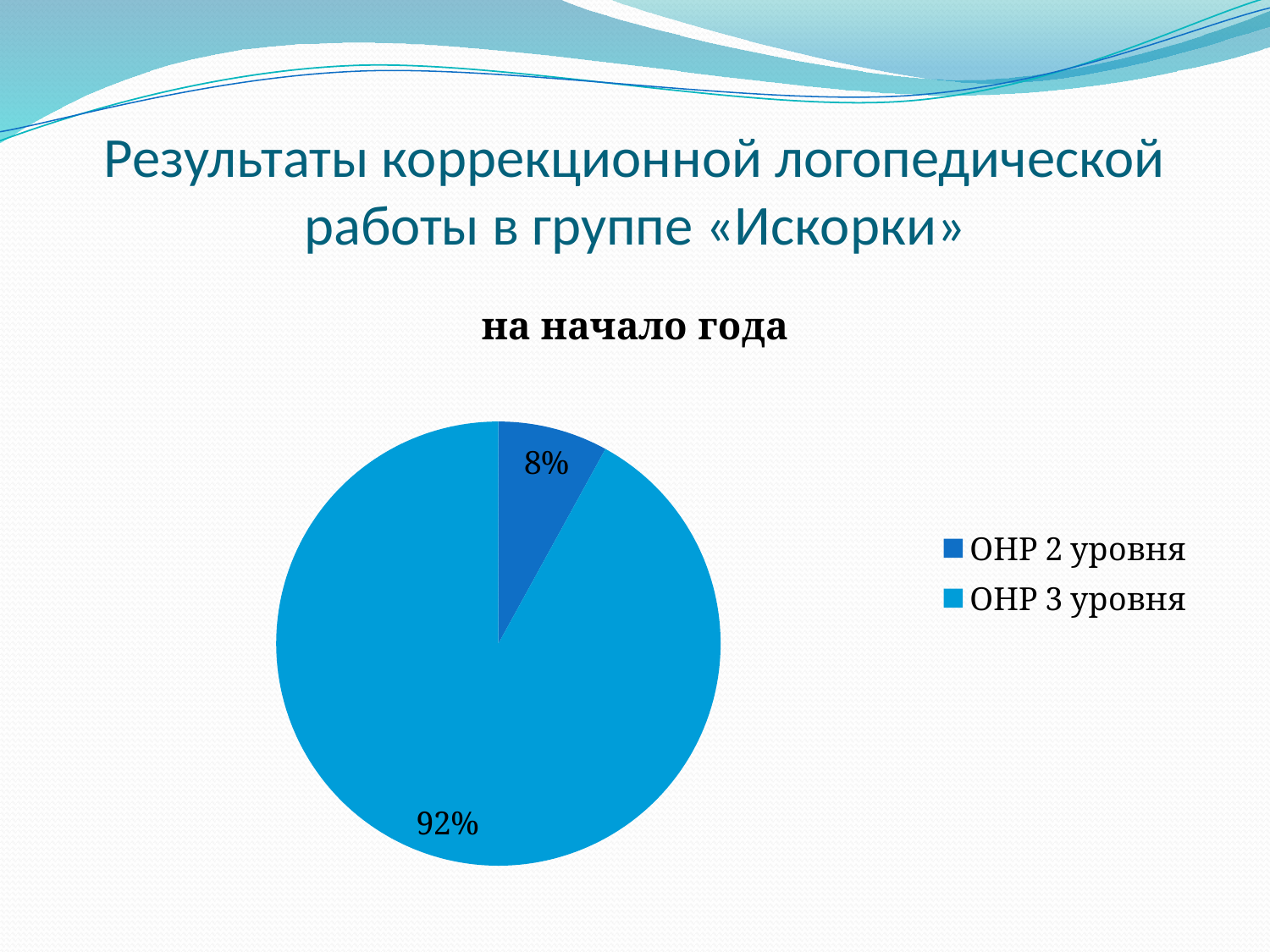
Which legend entry is shown in the darker blue colour? ОНР 2 уровня What is the difference in percentage points between ОНР 3 уровня and ОНР 2 уровня? 84 What kind of chart is shown on the slide? pie chart Which category has the largest slice of the pie? ОНР 3 уровня How many categories does the pie chart have? 2 Which is larger, the slice for ОНР 2 уровня or the slice for ОНР 3 уровня? ОНР 3 уровня Which category has the smallest slice of the pie? ОНР 2 уровня How many entries does the legend list? 2 What is the title of the chart? на начало года What share of the pie does ОНР 2 уровня take? 8% What share of the pie does ОНР 3 уровня take? 92%